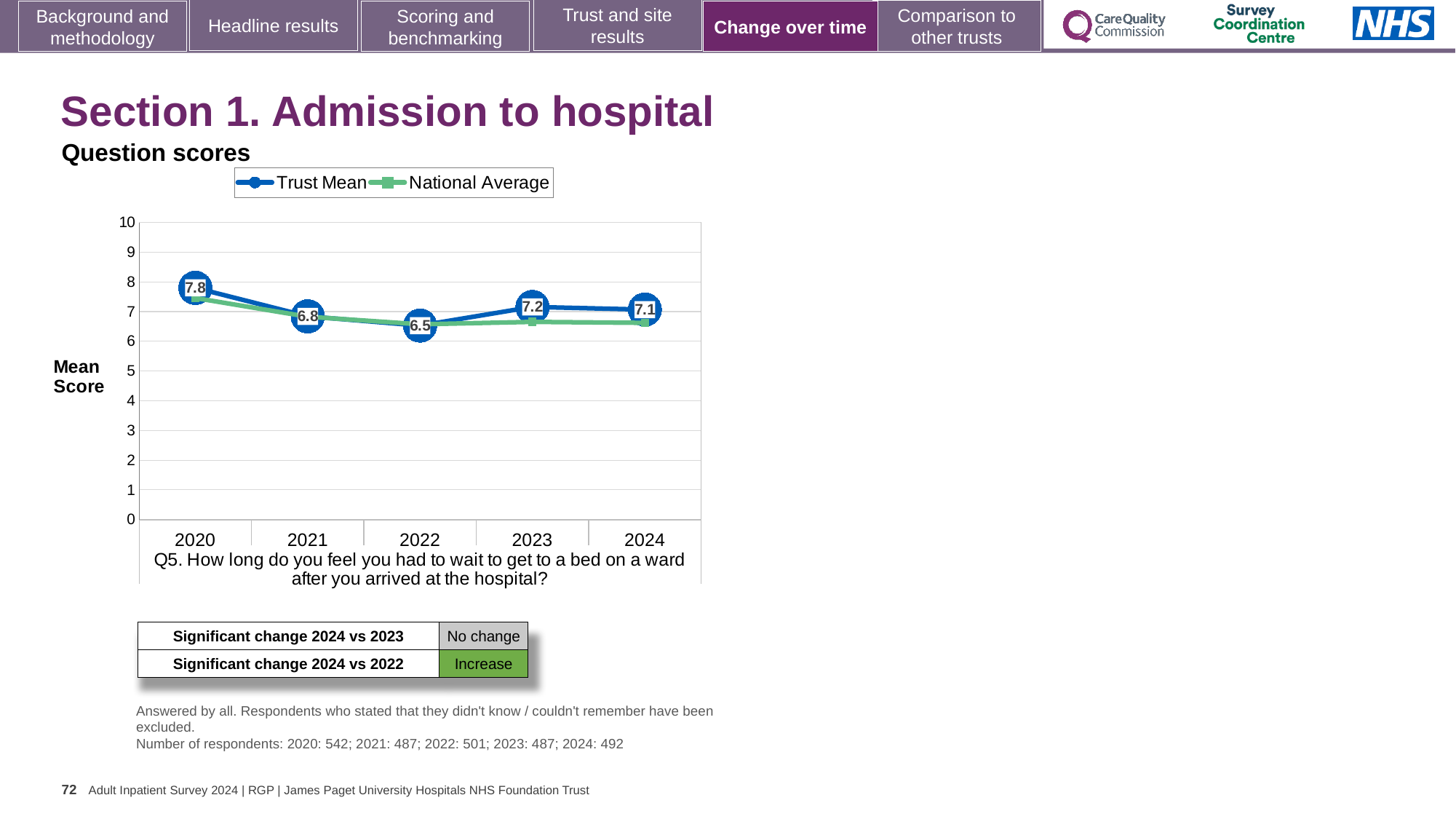
How many series does the legend list? 2 How many years are shown on the x axis? 5 What is the difference between the Trust Mean scores for 2020 and 2022? 1.3 In which year is the Trust Mean score highest? 2020 What is the Trust Mean score for 2024? 7.1 What kind of chart is shown on the slide? line chart What is the Trust Mean score for 2020? 7.8 Does the Trust Mean score rise or fall from 2020 to 2022? fall Which is larger, the Trust Mean score for 2021 or for 2023? 2023 What is the Trust Mean score for 2022? 6.5 Is the National Average value for 2024 greater or less than 7? less In which year is the Trust Mean score lowest? 2022